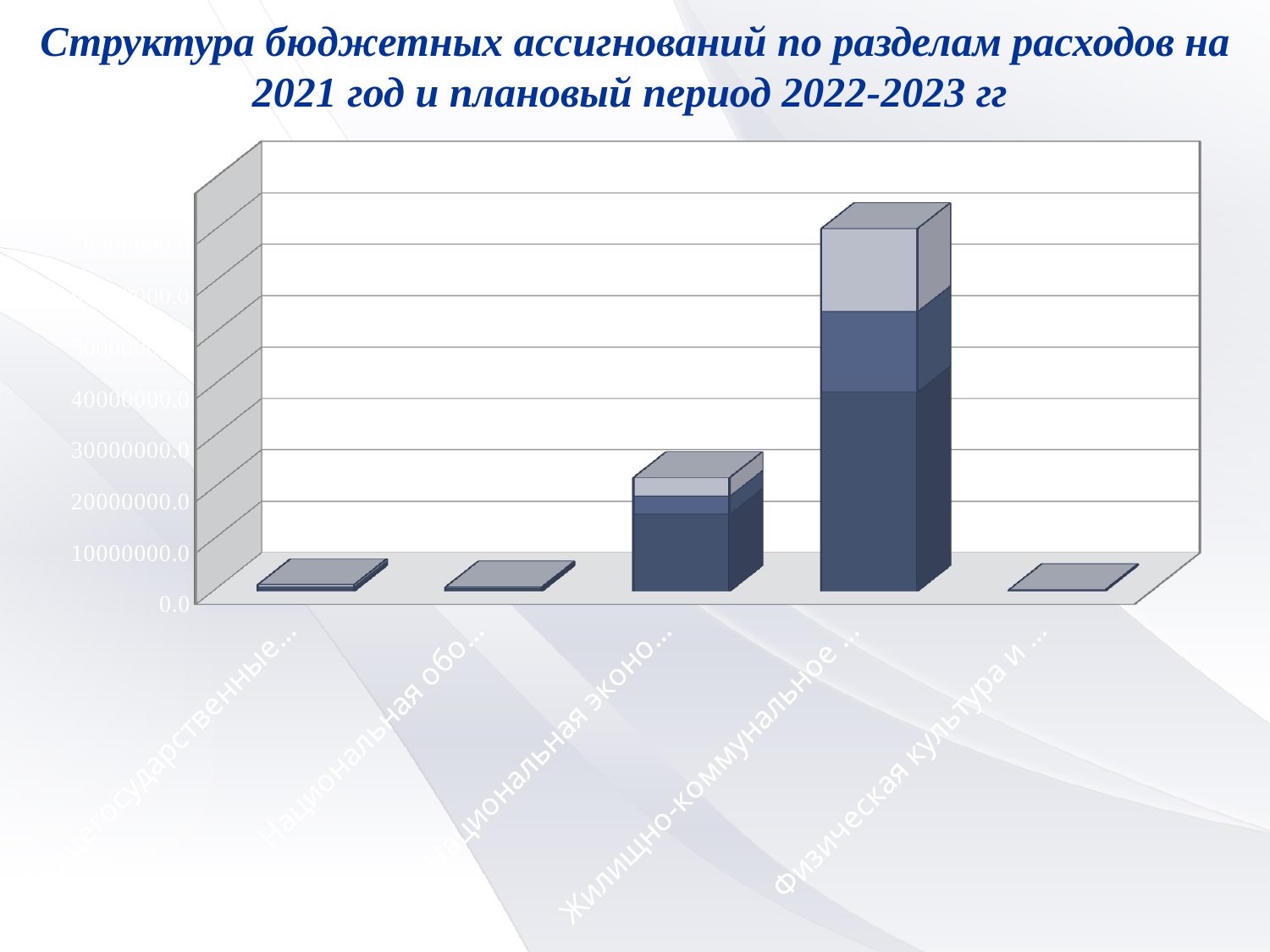
Is the value of the "Физическая культура и ..." bar greater or less than 10000000.0? less How many stacked segments make up the tallest bar in the chart? 3 How many categories are shown along the x axis of the chart? 5 Is the total value of the "Национальная эконо..." bar greater or less than 30000000.0? less Which bar is taller: "Национальная эконо..." or "Жилищно-коммунальное ..."? Жилищно-коммунальное ... Is the total value of the "Национальная эконо..." bar greater or less than 10000000.0? greater What kind of chart is shown on the slide? bar chart Which category has the tallest bar in the chart? Жилищно-коммунальное ... What is the title of the slide? Структура бюджетных ассигнований по разделам расходов на 2021 год и плановый период 2022-2023 гг